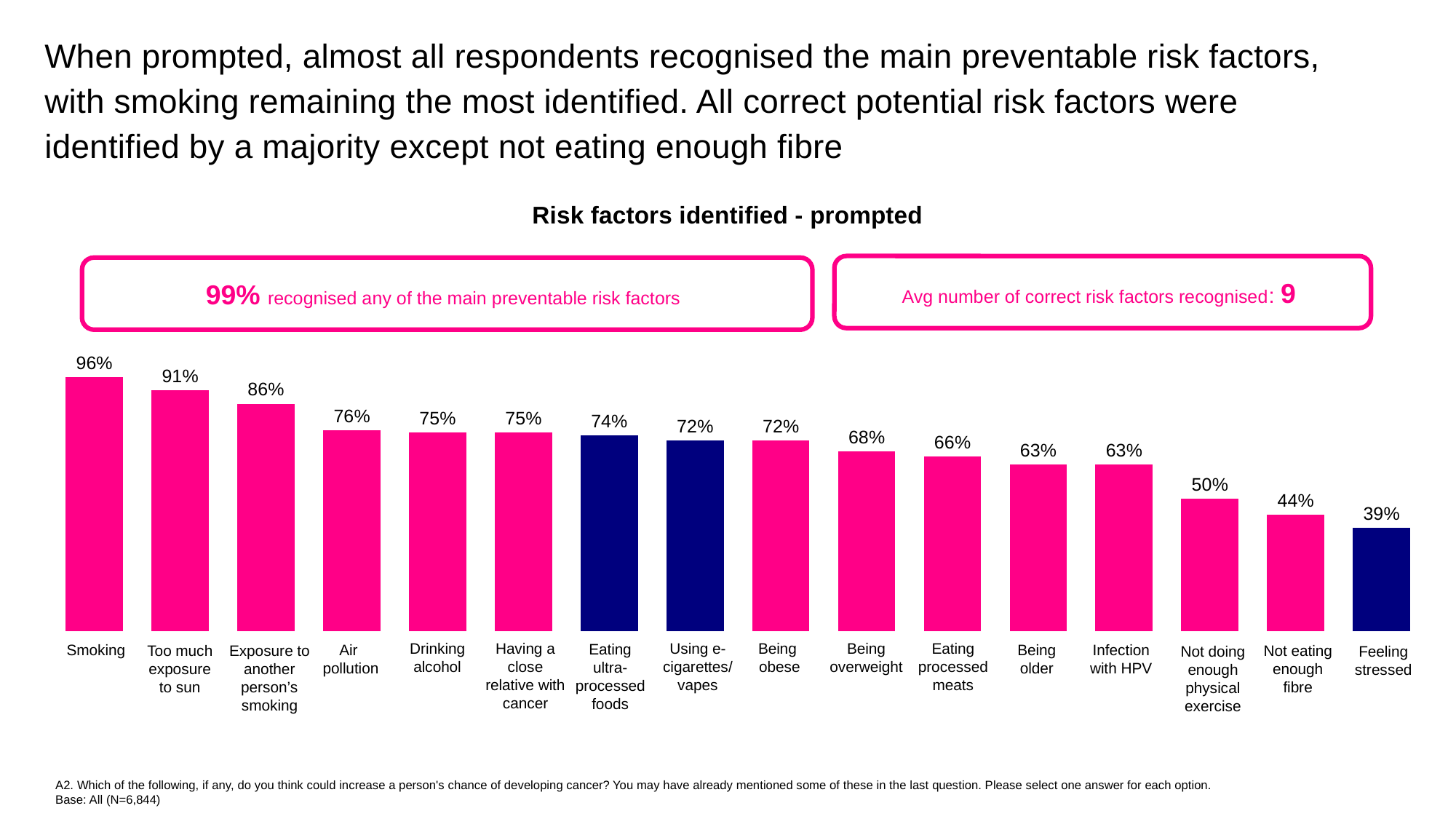
What is the difference between the values for 'Too much exposure to sun' and 'Air pollution'? 15 percentage points Do the values rise or fall from left to right across the chart? Fall Which is larger: the value for 'Being overweight' or the value for 'Being older'? Being overweight What is the value for 'Not eating enough fibre'? 44% What is the value for 'Infection with HPV'? 63% Which risk factor has the lowest value? Feeling stressed What is the difference between the values for 'Smoking' and 'Feeling stressed'? 57 percentage points Which risk factor has the highest value? Smoking What is the title of the chart? Risk factors identified - prompted What type of chart is shown on the slide? Bar chart How many risk factor categories are shown in the chart? 16 What percentage of respondents identified smoking as a risk factor? 96%